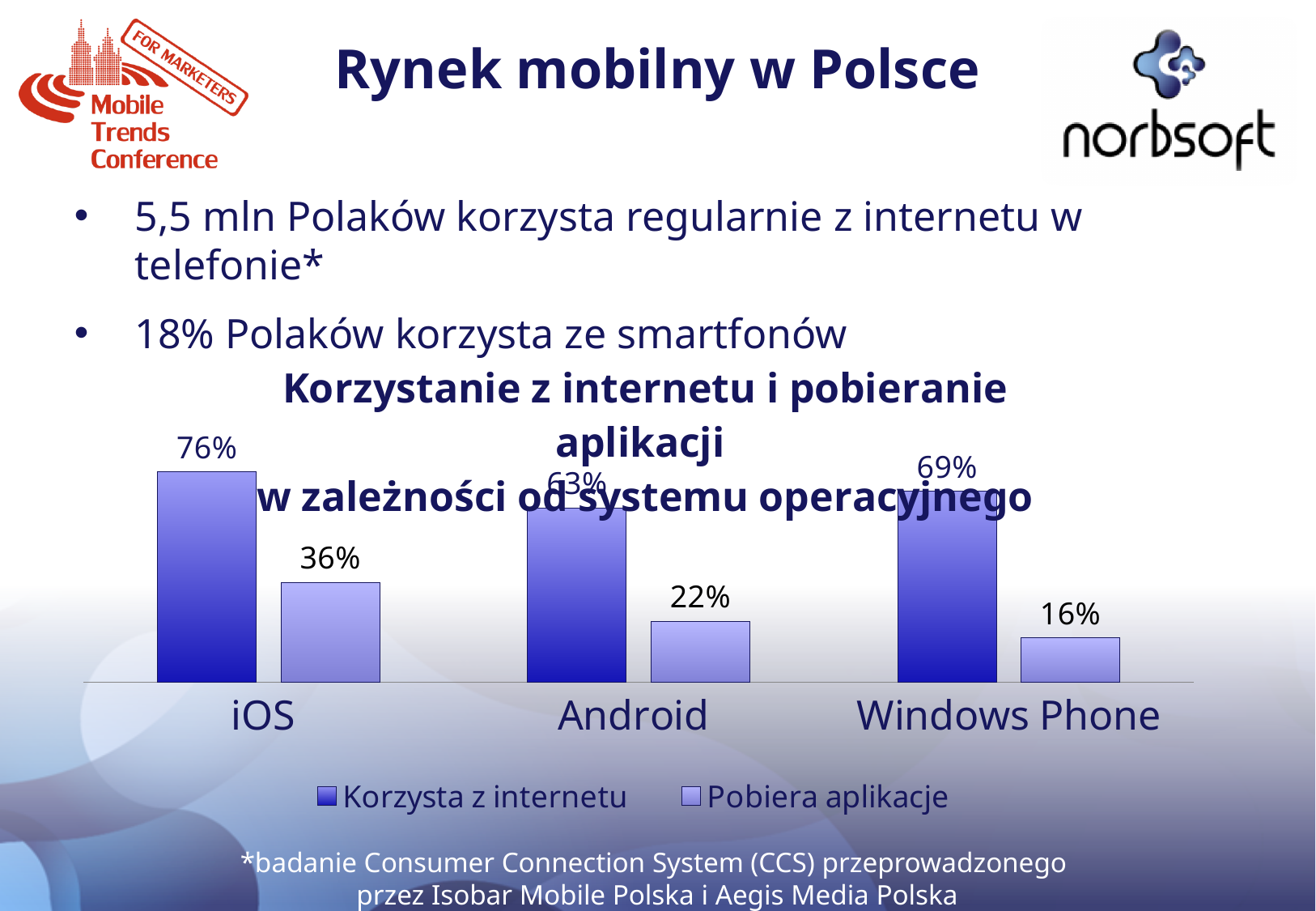
Which is larger: the "Korzysta z internetu" value for Windows Phone or for Android? Windows Phone How many operating systems are shown on the x axis? 3 Which operating system has the lowest value in the "Pobiera aplikacje" series? Windows Phone What is the difference between the "Korzysta z internetu" and "Pobiera aplikacje" values for iOS? 40% What is the value for iOS in the "Korzysta z internetu" series? 76% What is the value for Windows Phone in the "Pobiera aplikacje" series? 16% What is the difference between the "Pobiera aplikacje" values for iOS and Android? 14% What is the value for Android in the "Pobiera aplikacje" series? 22% How many series does the legend list? 2 Which operating system has the highest value in the "Korzysta z internetu" series? iOS What is the value for Windows Phone in the "Korzysta z internetu" series? 69% What kind of chart is shown on the slide? Bar chart